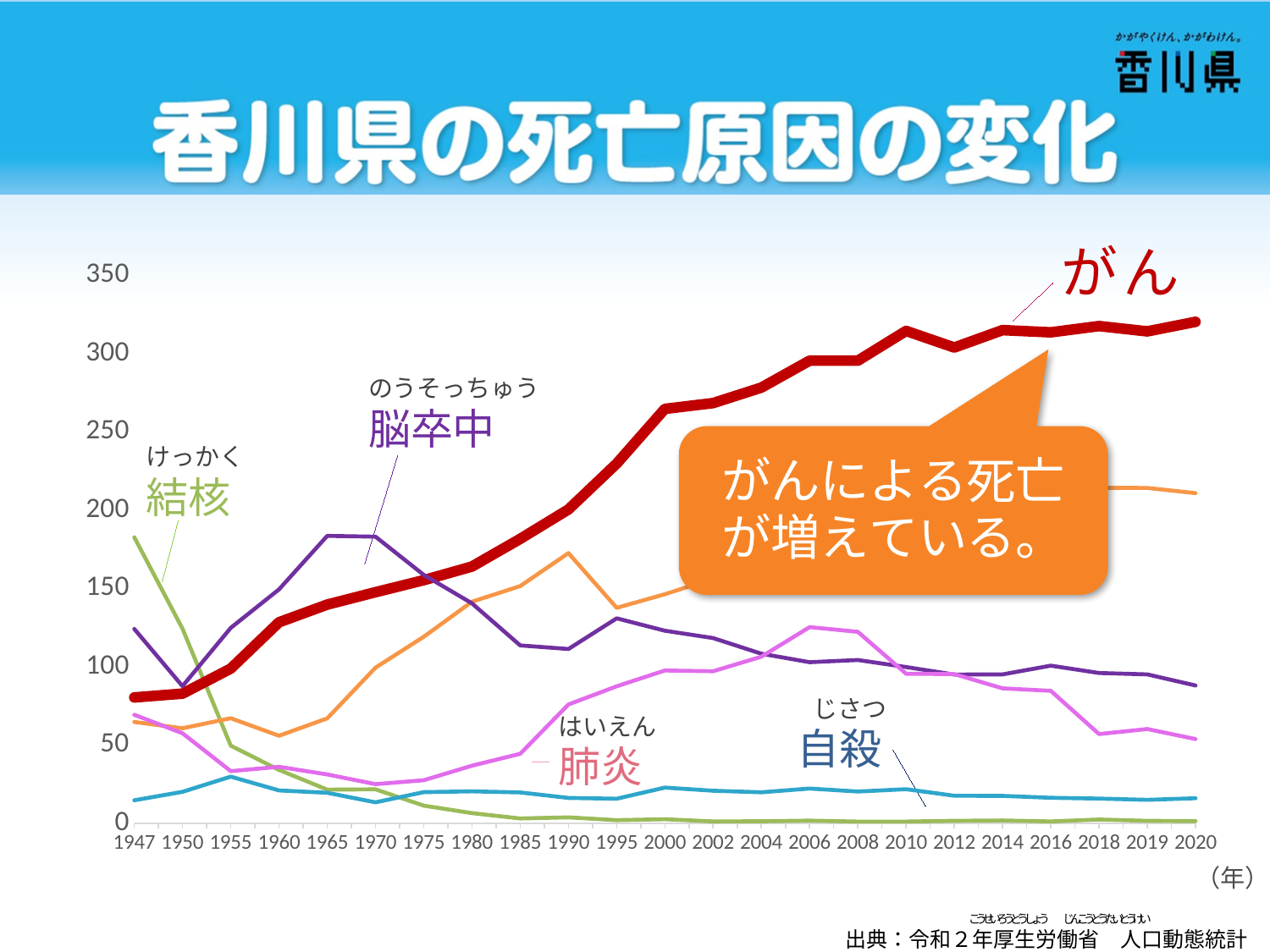
Which cause of death has the highest value in 2020? がん What is the title of the slide's chart? 香川県の死亡原因の変化 Which labelled cause of death has the lowest value in 2020? 結核 In 2020, which is higher, 脳卒中 or 肺炎? 脳卒中 Is the value for 脳卒中 in 1965 greater or less than 150? greater What kind of chart is shown on the slide? line chart In 1947, which is higher, 結核 or 脳卒中? 結核 Does the line for 結核 rise or fall from 1947 to 2020? falls Does the line for がん rise or fall from 1947 to 2020? rises Is the value for 結核 in 2020 greater or less than 50? less Is the value for がん in 2020 greater or less than 300? greater